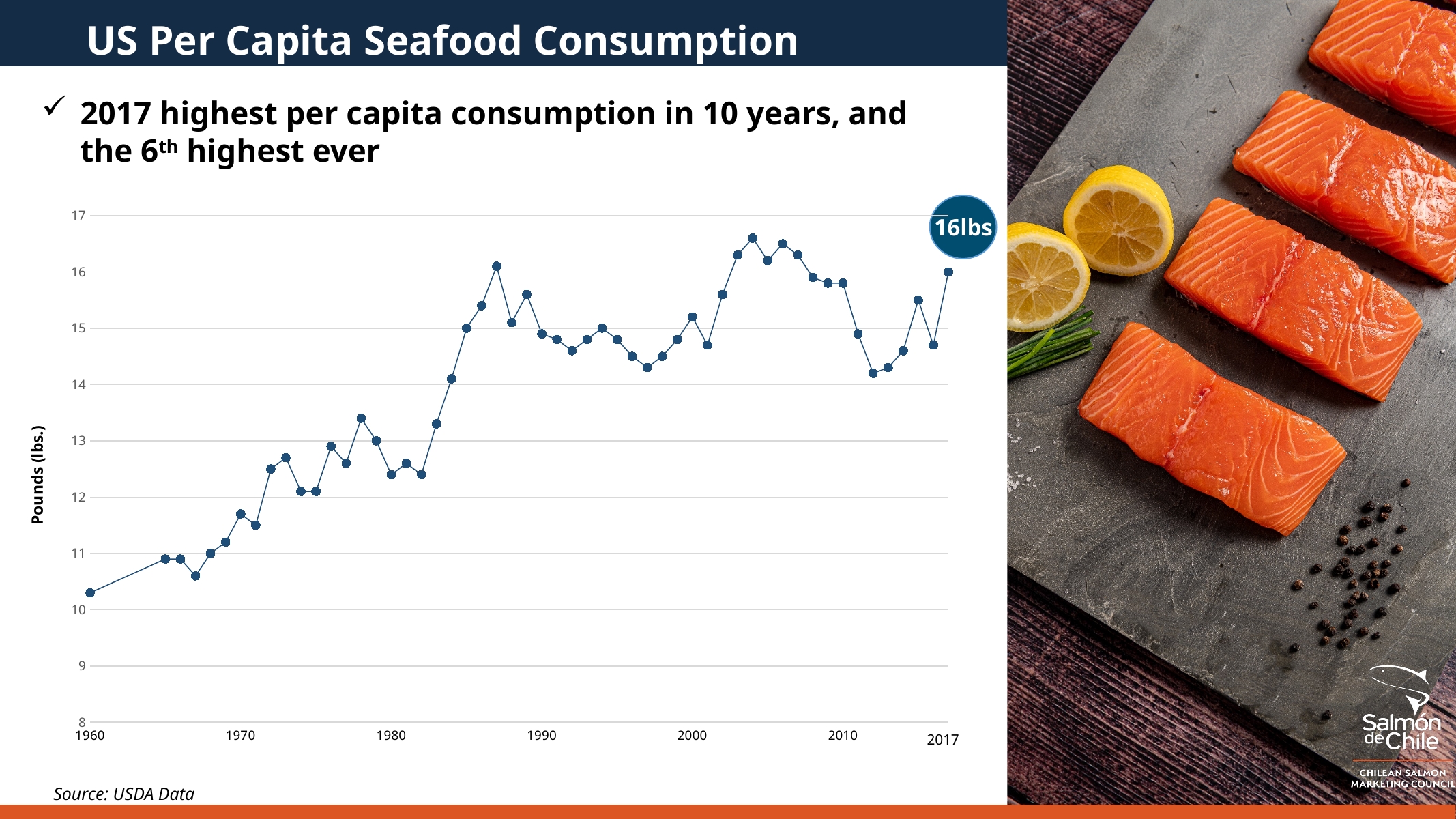
Is the value for 1960 greater or less than 11? less Is the value for 1980 greater or less than 13? less Is the value for 1990 greater or less than 14? greater Which labeled year on the x axis has the lowest value? 1960 Overall, do the values rise or fall from 1960 to 2017? rise Which is larger, the value for 1980 or the value for 1990? 1990 Which is larger, the value for 1960 or the value for 2017? 2017 What is the per capita seafood consumption value labeled for 2017? 16lbs What kind of chart is shown on the slide? line chart What is the label on the y axis of the chart? Pounds (lbs.)